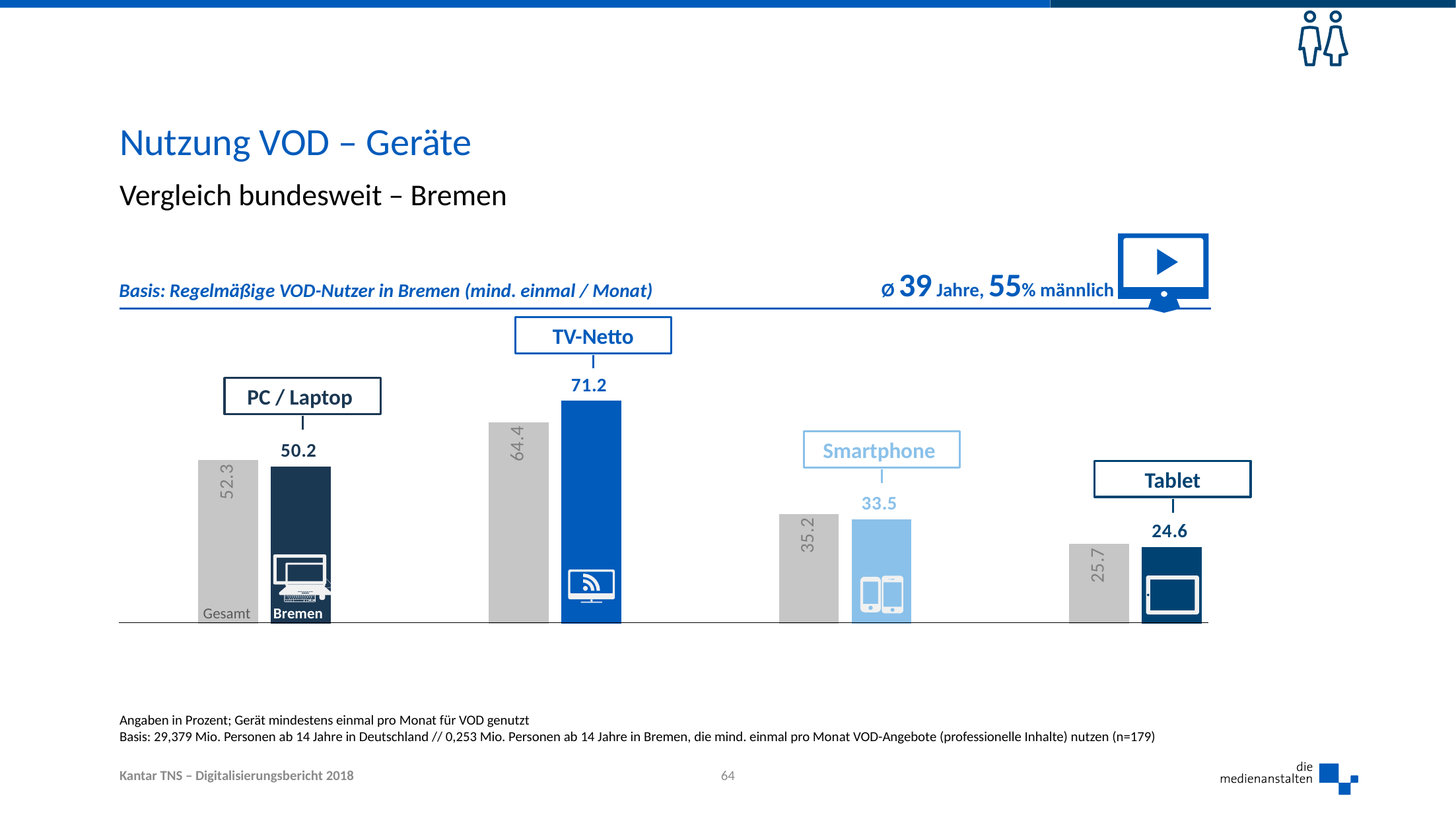
Which device has the lowest Gesamt value? Tablet What is the Bremen value for TV-Netto? 71.2 What kind of chart is shown on the slide? Bar chart How many series does the chart compare for each device? 2 Which device has the highest Bremen value? TV-Netto What is the Gesamt value for PC / Laptop? 52.3 How many device categories are shown in the chart? 4 What is the difference between the Gesamt and Bremen values for PC / Laptop? 2.1 What is the difference between the Bremen and Gesamt values for TV-Netto? 6.8 What is the Gesamt value for Tablet? 25.7 For Smartphone, which is larger: the Gesamt value or the Bremen value? Gesamt What is the Bremen value for Smartphone? 33.5